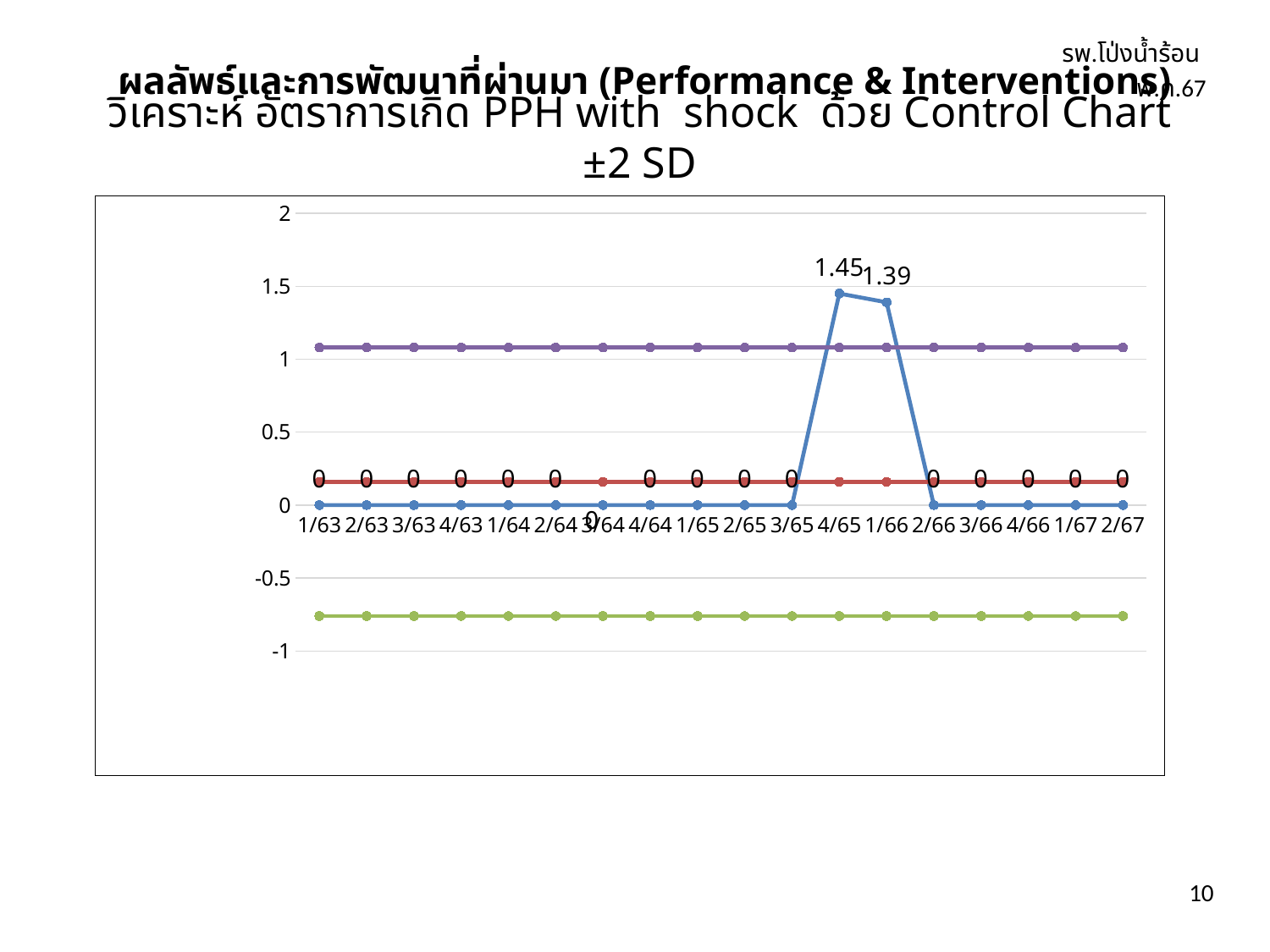
What is the difference between the values for 4/65 and 1/66? 0.06 Is the value of the purple upper line at 1/63 greater or less than 1.5? less What is the first period label on the x axis of the chart? 1/63 What is the highest value shown on the y axis of the chart? 2 What is the PPH with shock rate plotted for 2/66? 0 Is the value of the green lower line at 1/63 greater or less than -0.5? less Which is larger, the value for 4/65 or the value for 1/66? 4/65 What is the PPH with shock rate plotted for 4/65? 1.45 How many periods are shown along the x axis of the chart? 18 What kind of chart is shown on the slide? line chart What is the PPH with shock rate plotted for 1/66? 1.39 Which period has the highest PPH with shock rate on the chart? 4/65